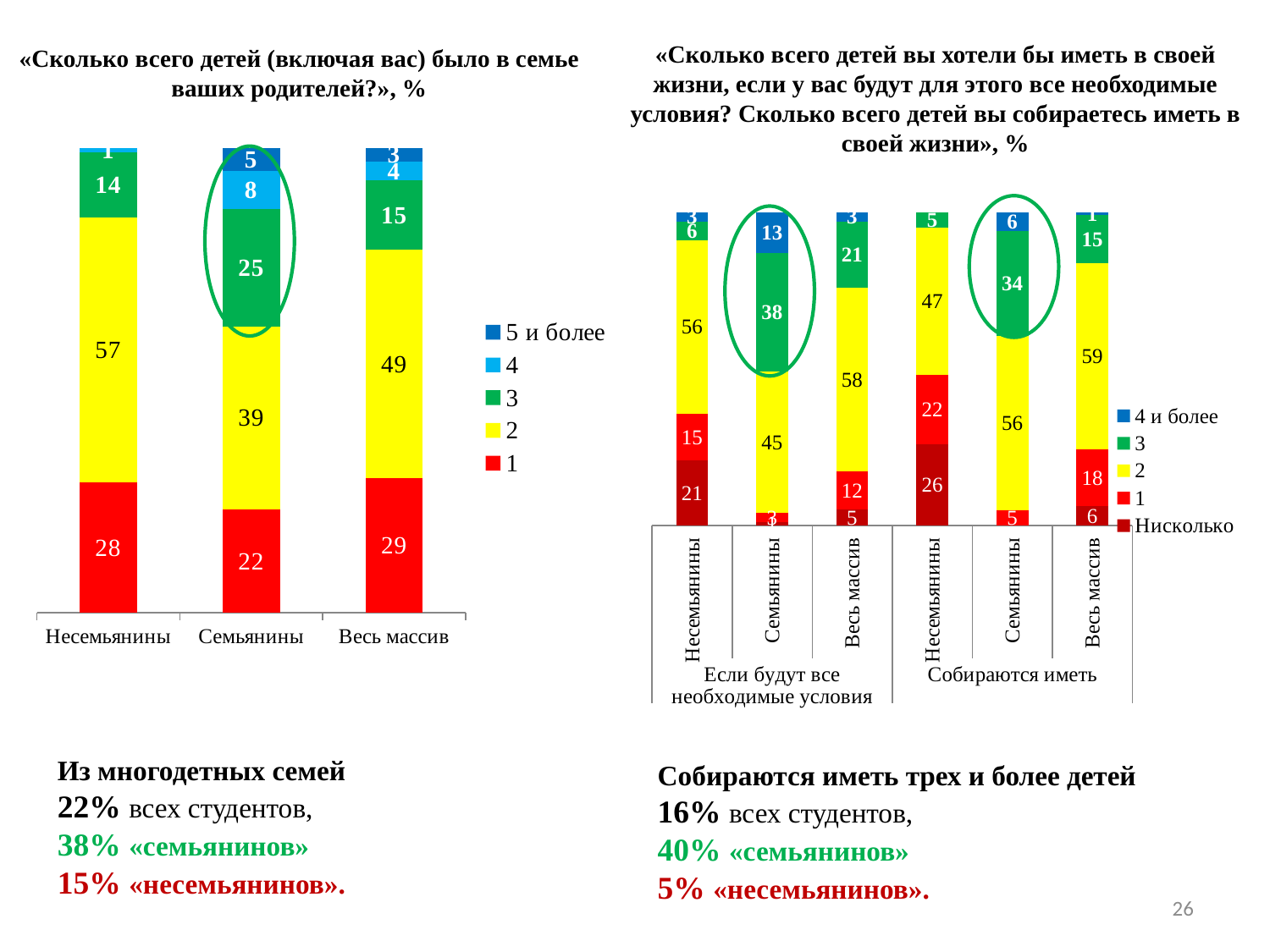
In the right chart, which is larger: the "3" segment for Семьянины or for Несемьянины in the group "Собираются иметь"? Семьянины In the right chart, what is the value of the "Нисколько" segment for Несемьянины in the group "Собираются иметь"? 26 In the left chart, what is the value of the "1" segment for Весь массив? 29 In the left chart, how many series does the legend list? 5 In the right chart, what is the value of the "2" segment for Весь массив in the group "Собираются иметь"? 59 What type of chart is the left chart? Stacked bar chart In the right chart, how many bars are plotted in total? 6 In the left chart, what is the difference between the "2" segment for Несемьянины and for Семьянины? 18 In the left chart ("Сколько всего детей (включая вас) было в семье ваших родителей?"), what is the value of the "2" segment for Семьянины? 39 In the right chart ("Сколько всего детей вы хотели бы иметь..."), what is the value of the "3" segment for Семьянины in the group "Если будут все необходимые условия"? 38 In the left chart, which category has the largest "2" segment? Несемьянины In the left chart, what is the value of the "3" segment for Семьянины? 25